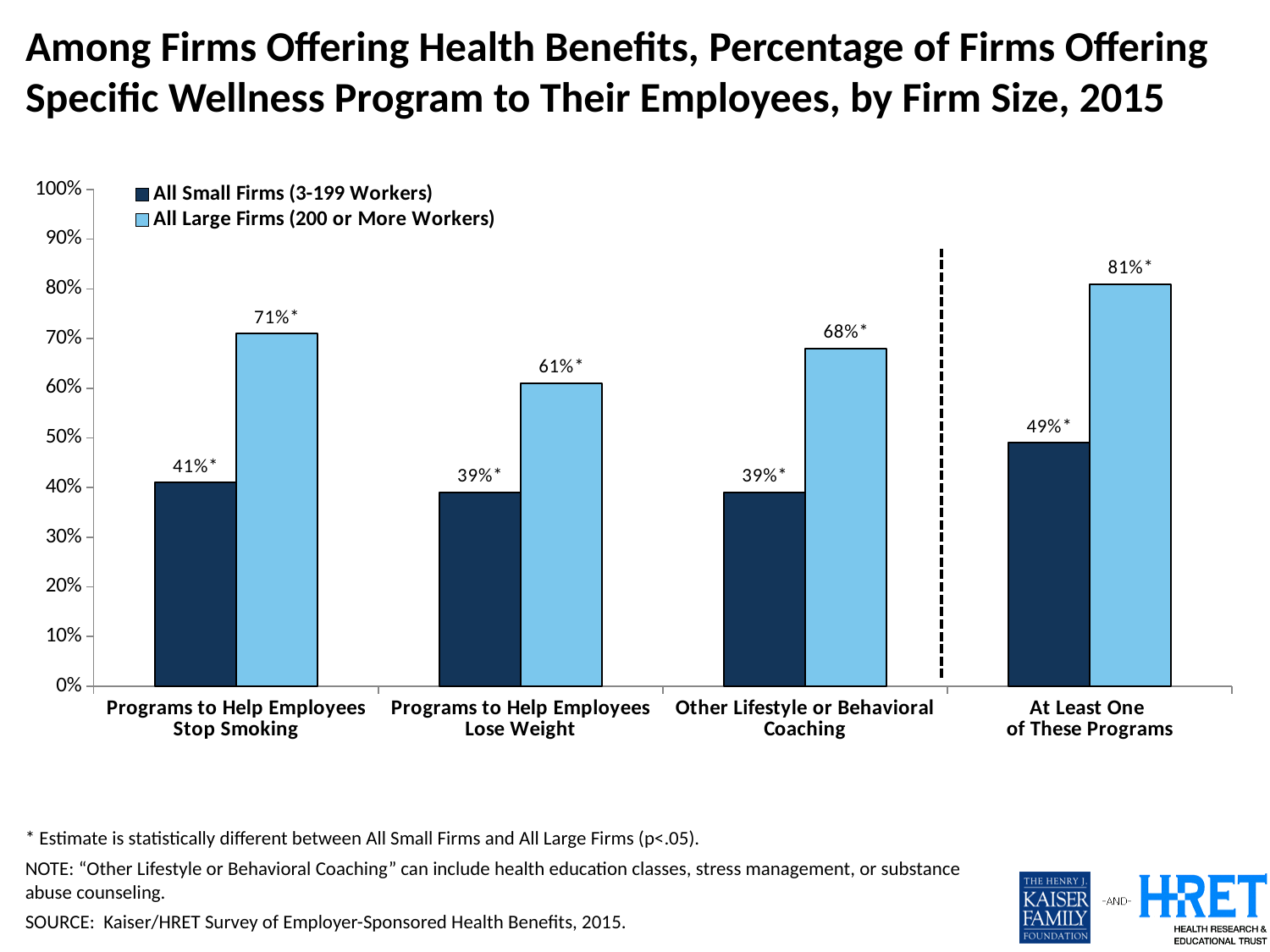
Which category has the highest value for All Large Firms (200 or More Workers)? At Least One of These Programs Which category has the lowest value for All Large Firms (200 or More Workers)? Programs to Help Employees Lose Weight What does the asterisk (*) next to the values indicate? Estimate is statistically different between All Small Firms and All Large Firms (p<.05) What percentage of All Large Firms (200 or More Workers) offer At Least One of These Programs? 81% What percentage of All Large Firms (200 or More Workers) offer Other Lifestyle or Behavioral Coaching? 68% What is the difference between All Large Firms and All Small Firms for At Least One of These Programs? 32 percentage points How many series does the legend list? 2 What kind of chart is shown on the slide? Bar chart What percentage of All Small Firms (3-199 Workers) offer Programs to Help Employees Stop Smoking? 41% How many categories are shown on the x axis? 4 Which is larger for Programs to Help Employees Lose Weight: All Small Firms or All Large Firms? All Large Firms (200 or More Workers) What is the difference between All Large Firms and All Small Firms for Programs to Help Employees Stop Smoking? 30 percentage points